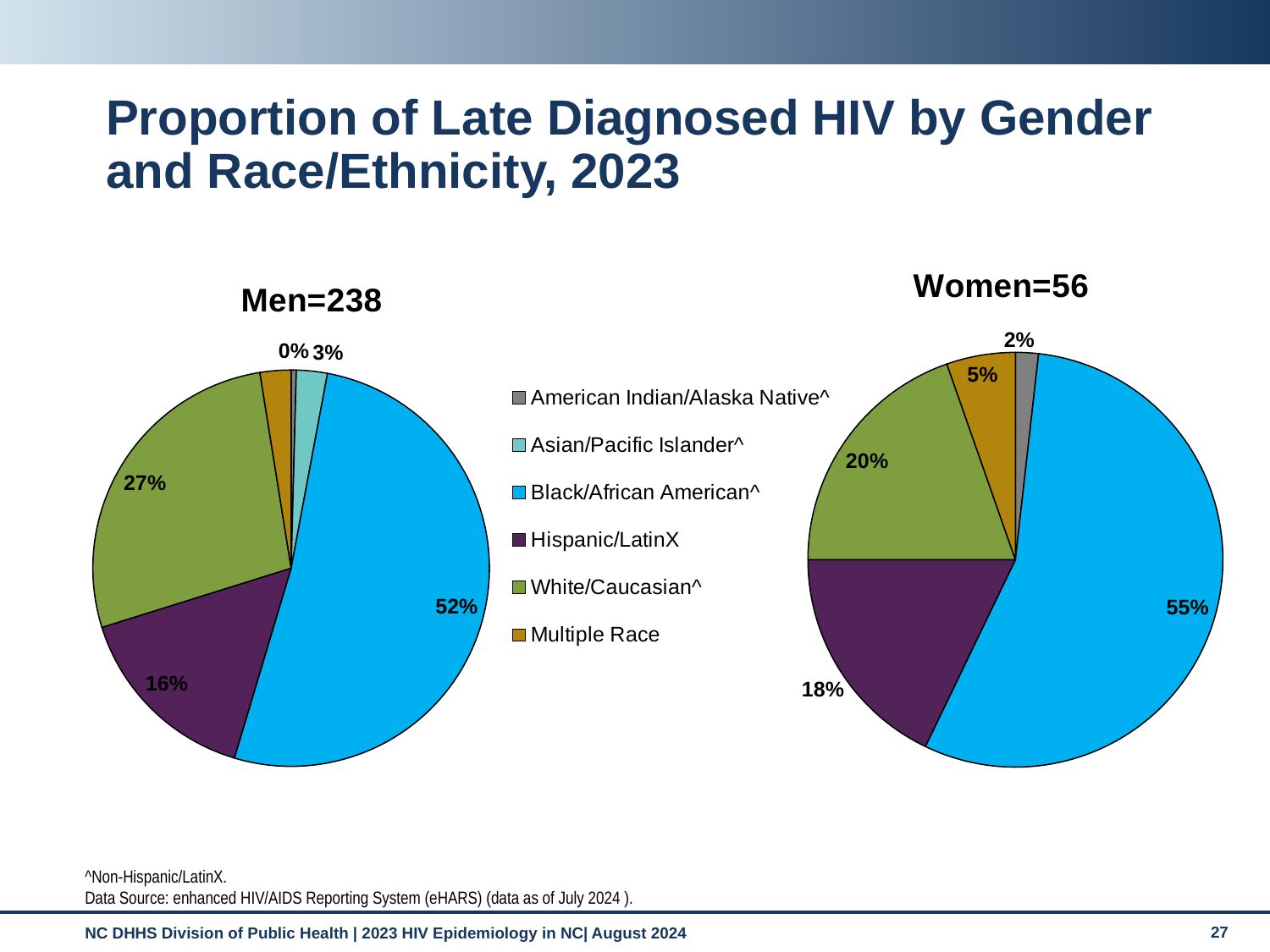
In the Women=56 chart, what share of late diagnosed HIV is Black/African American? 55% In the Men=238 chart, what percentage is shown for Asian/Pacific Islander? 3% In the Women=56 chart, what percentage is shown for Multiple Race? 5% In the Women=56 chart, what percentage is shown for Hispanic/LatinX? 18% How many race/ethnicity categories does the legend list? 6 In the Men=238 chart, what share of late diagnosed HIV is Black/African American? 52% In the Men=238 chart, what percentage is shown for White/Caucasian? 27% What kind of charts are shown on the slide? Pie charts In the Men=238 chart, what is the difference between the White/Caucasian and Hispanic/LatinX percentages? 11% Which is larger in the Women=56 chart: the White/Caucasian slice or the Hispanic/LatinX slice? White/Caucasian In the Women=56 chart, which race/ethnicity has the largest slice? Black/African American In the Men=238 chart, which race/ethnicity has the largest slice? Black/African American